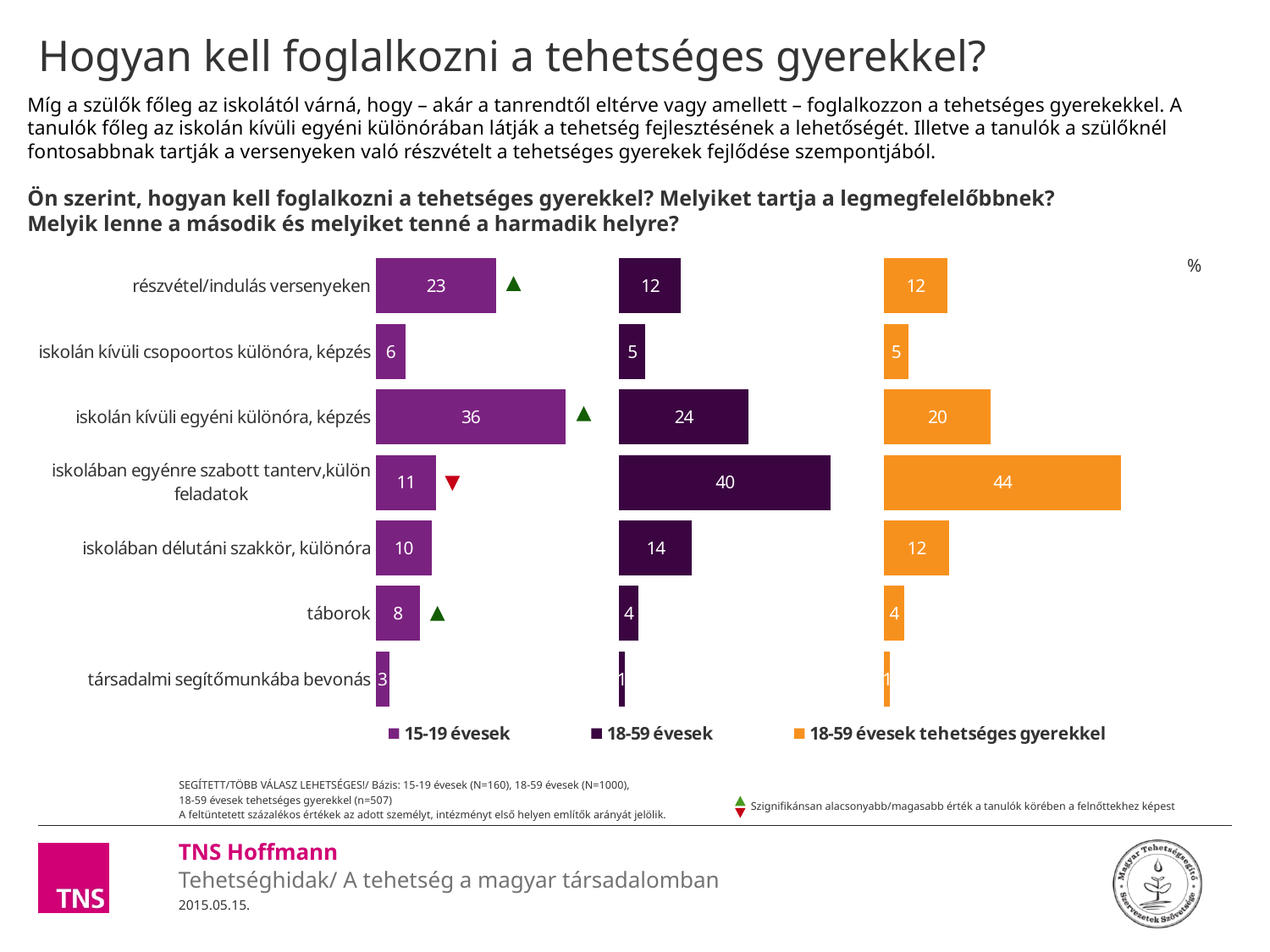
What is the value for "iskolában délutáni szakkör, különóra" in the 18-59 évesek series? 14 How many categories are shown on the chart? 7 What is the difference between the 18-59 évesek tehetséges gyerekkel value and the 15-19 évesek value for "iskolában egyénre szabott tanterv,külön feladatok"? 33 Which category has the lowest value in the 18-59 évesek series? társadalmi segítőmunkába bevonás How many series does the legend list? 3 What kind of chart is shown on the slide? bar chart What is the value for "iskolán kívüli egyéni különóra, képzés" in the 15-19 évesek series? 36 For "táborok", which series has the larger value: 15-19 évesek or 18-59 évesek? 15-19 évesek What is the value for "részvétel/indulás versenyeken" in the 18-59 évesek series? 12 Which category has the highest value in the 15-19 évesek series? iskolán kívüli egyéni különóra, képzés What is the value for "iskolában egyénre szabott tanterv,külön feladatok" in the 18-59 évesek tehetséges gyerekkel series? 44 Which series is shown in orange in the legend? 18-59 évesek tehetséges gyerekkel